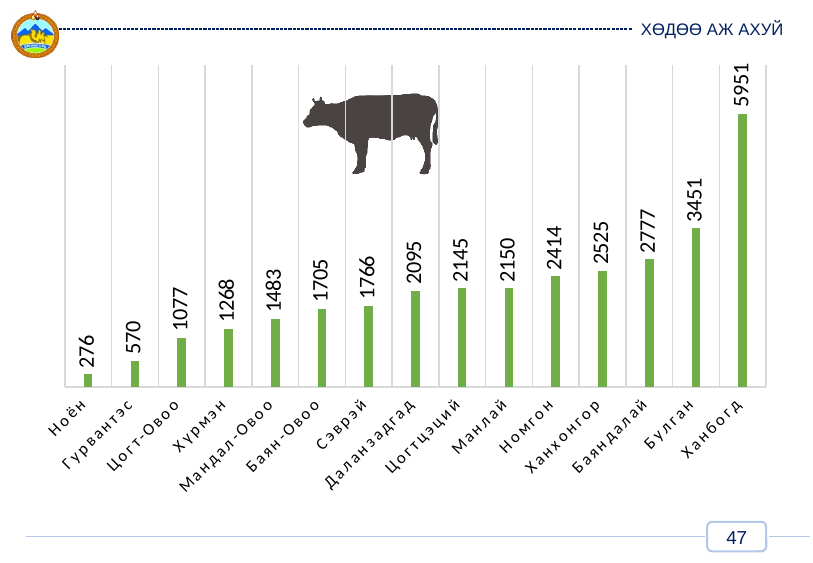
Do the values rise or fall from left to right along the x axis? Rise What is the difference between the values for Гурвантэс and Ноён? 294 Which category has the highest value? Ханбогд What is the difference between the values for Ханбогд and Булган? 2500 Which category has the lowest value? Ноён What is the value for Мандал-Овоо? 1483 What kind of chart is shown on the slide? Bar chart How many categories are shown on the chart? 15 Which is larger, the value for Номгон or the value for Ханхонгор? Ханхонгор What is the value for Ханбогд? 5951 What is the value for Даланзадгад? 2095 Which is larger, the value for Сэврэй or the value for Хүрмэн? Сэврэй